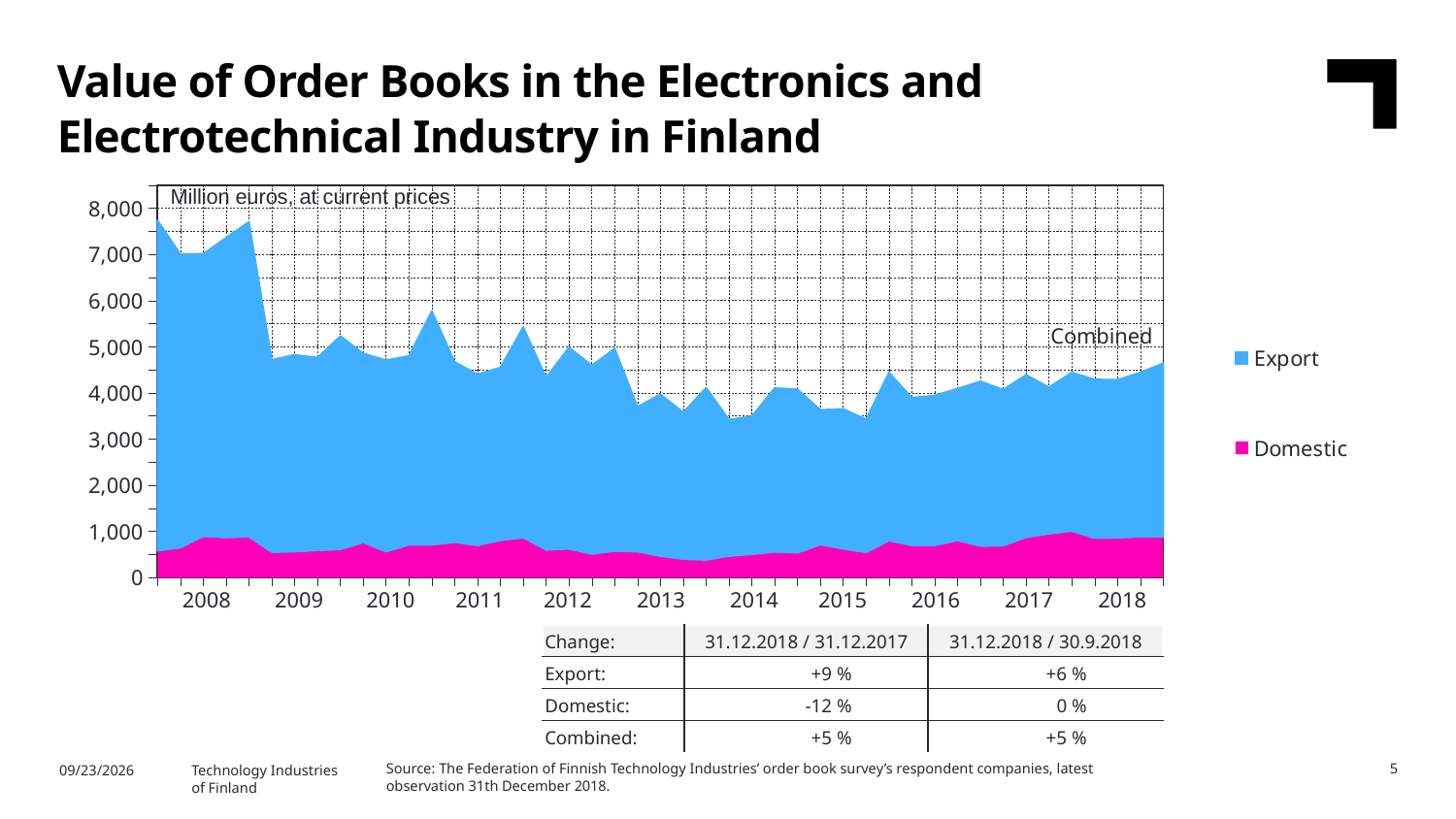
How many years are labelled on the x axis of the chart? 11 Which series is larger throughout the chart, Export or Domestic? Export Is the combined value larger in 2008 or in 2018? 2008 Overall, does the combined value of order books rise or fall from 2008 to 2018? Fall Is the Domestic value in 2014 greater or less than 1,000? less In which year does the combined value of order books reach its highest level? 2008 What unit is stated at the top of the chart? Million euros, at current prices Is the combined value at the start of 2008 greater or less than 7,000? greater What kind of chart is shown on the slide? Stacked area chart Which two series are listed in the chart legend? Export and Domestic How many series does the chart legend list? 2 Is the combined value at the end of 2018 greater or less than 5,000? less